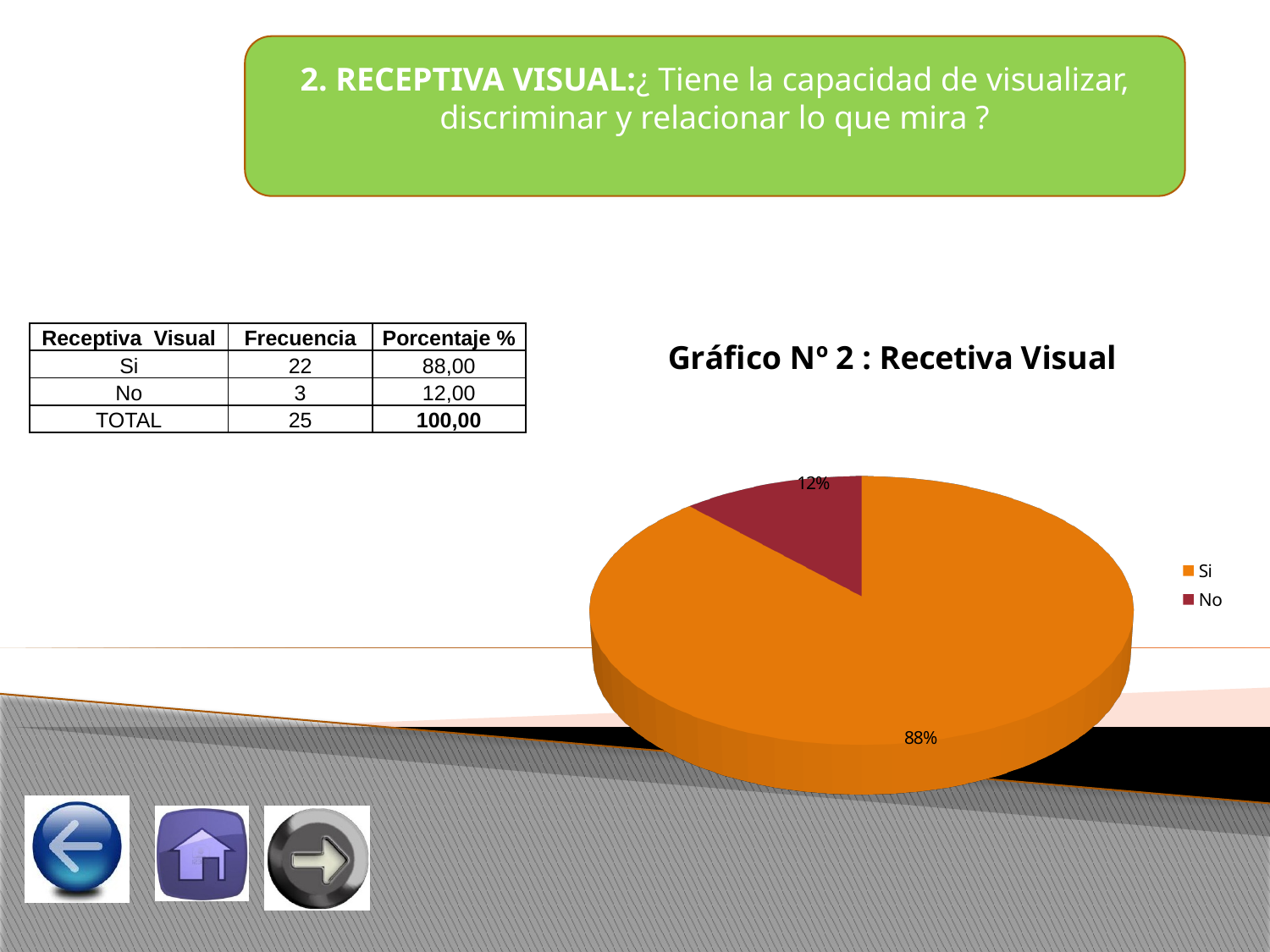
How many categories does the legend list? 2 Which category has the largest slice of the pie? Si What percentage of the pie does the 'No' slice represent? 12% Which slice is larger, 'Si' or 'No'? Si How many slices does the pie chart have? 2 What colour is the 'No' slice in the pie chart? dark red Which category has the smallest slice of the pie? No What is the difference in percentage points between the 'Si' and 'No' slices? 76 What type of chart is shown on the slide? pie chart Is the share of the 'Si' slice greater or less than 50%? greater What percentage of the pie does the 'Si' slice represent? 88% What is the title of the chart? Gráfico Nº 2 : Recetiva Visual